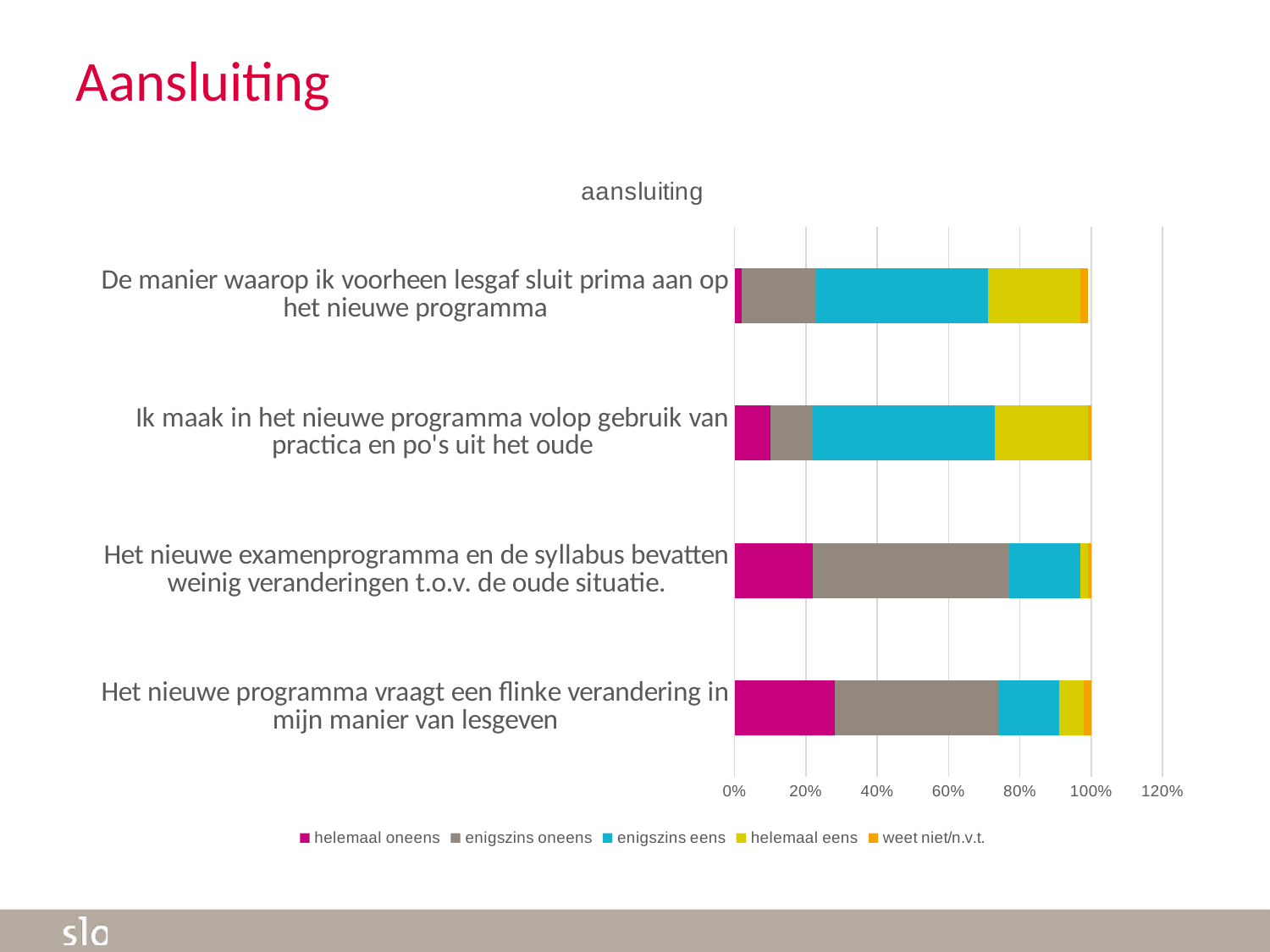
What is the title of the chart? aansluiting Is the 'helemaal oneens' share for 'Het nieuwe programma vraagt een flinke verandering in mijn manier van lesgeven' greater or less than 20%? greater How many statements (categories) are plotted in the chart? 4 Which statement has the smallest 'helemaal eens' segment? Het nieuwe examenprogramma en de syllabus bevatten weinig veranderingen t.o.v. de oude situatie. How many series does the legend list? 5 Which statement has the larger 'enigszins eens' segment: 'De manier waarop ik voorheen lesgaf sluit prima aan op het nieuwe programma' or 'Het nieuwe examenprogramma en de syllabus bevatten weinig veranderingen t.o.v. de oude situatie.'? De manier waarop ik voorheen lesgaf sluit prima aan op het nieuwe programma What kind of chart is shown on the slide? Stacked bar chart Is the 'helemaal oneens' share for 'De manier waarop ik voorheen lesgaf sluit prima aan op het nieuwe programma' greater or less than 20%? less Which legend entry is shown in orange? weet niet/n.v.t. Is the 'enigszins eens' share for 'Ik maak in het nieuwe programma volop gebruik van practica en po's uit het oude' greater or less than 40%? greater Which statement has the largest 'helemaal oneens' segment? Het nieuwe programma vraagt een flinke verandering in mijn manier van lesgeven Which statement has the largest 'enigszins oneens' segment? Het nieuwe examenprogramma en de syllabus bevatten weinig veranderingen t.o.v. de oude situatie.